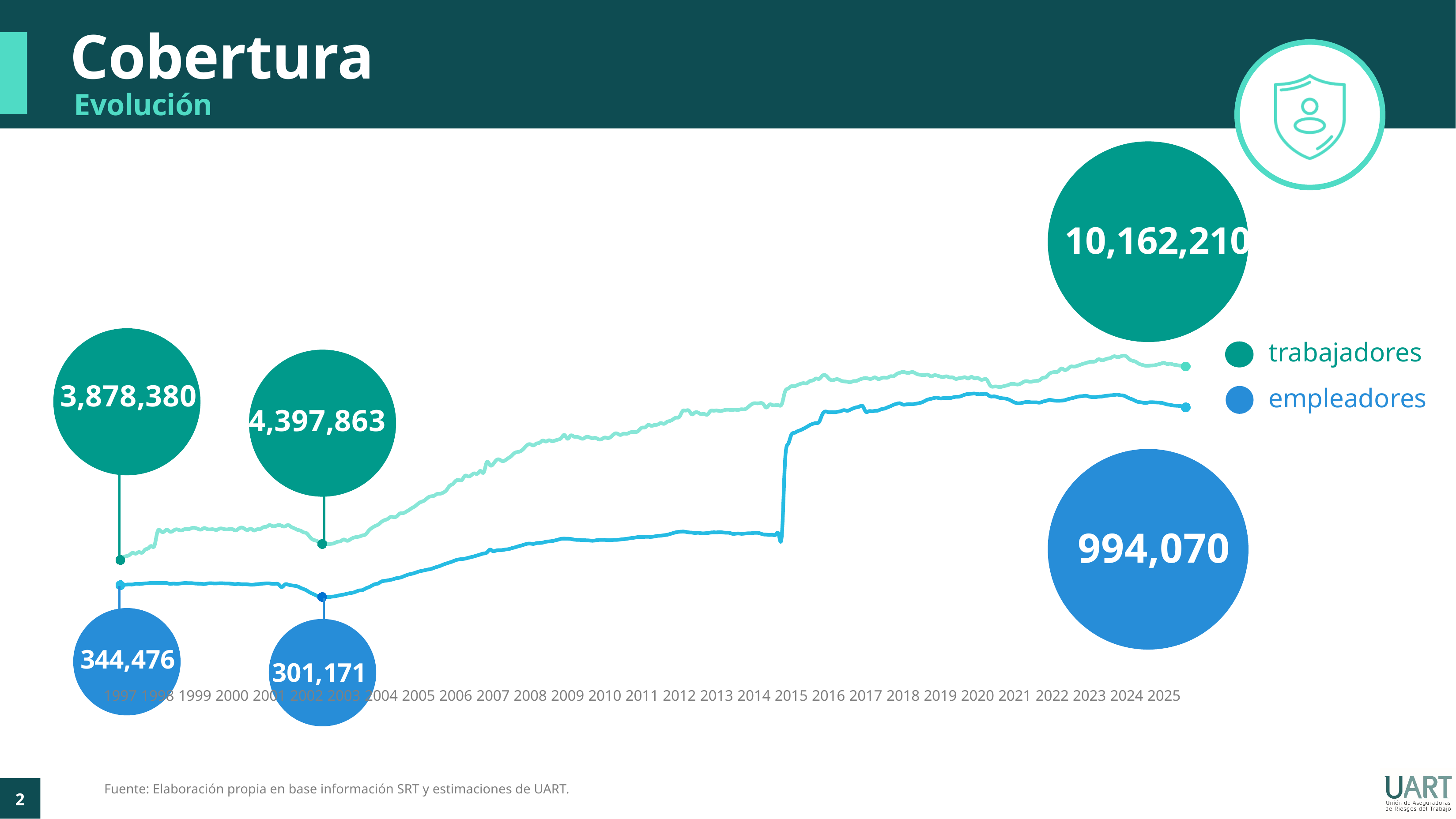
Overall, does the trabajadores line rise or fall from 1997 to 2025? rise What is the most recent value shown for trabajadores (the large green callout at the right)? 10,162,210 By how much did the trabajadores value increase from the 1997 callout (3,878,380) to the latest callout (10,162,210)? 6,283,830 What value is shown for trabajadores at the start of the series in 1997? 3,878,380 How many year labels are shown on the x axis, from 1997 to 2025? 29 What value is shown in the second blue callout for empleadores (the dip around 2002–2003)? 301,171 By how much did the empleadores value increase from the 1997 callout (344,476) to the latest callout (994,070)? 649,594 What kind of chart is shown on the slide? line chart What value is shown in the second green callout for trabajadores (around 2002–2003)? 4,397,863 How many series does the legend list? 2 What is the most recent value shown for empleadores (the large blue callout at the right)? 994,070 What value is shown for empleadores at the start of the series in 1997? 344,476